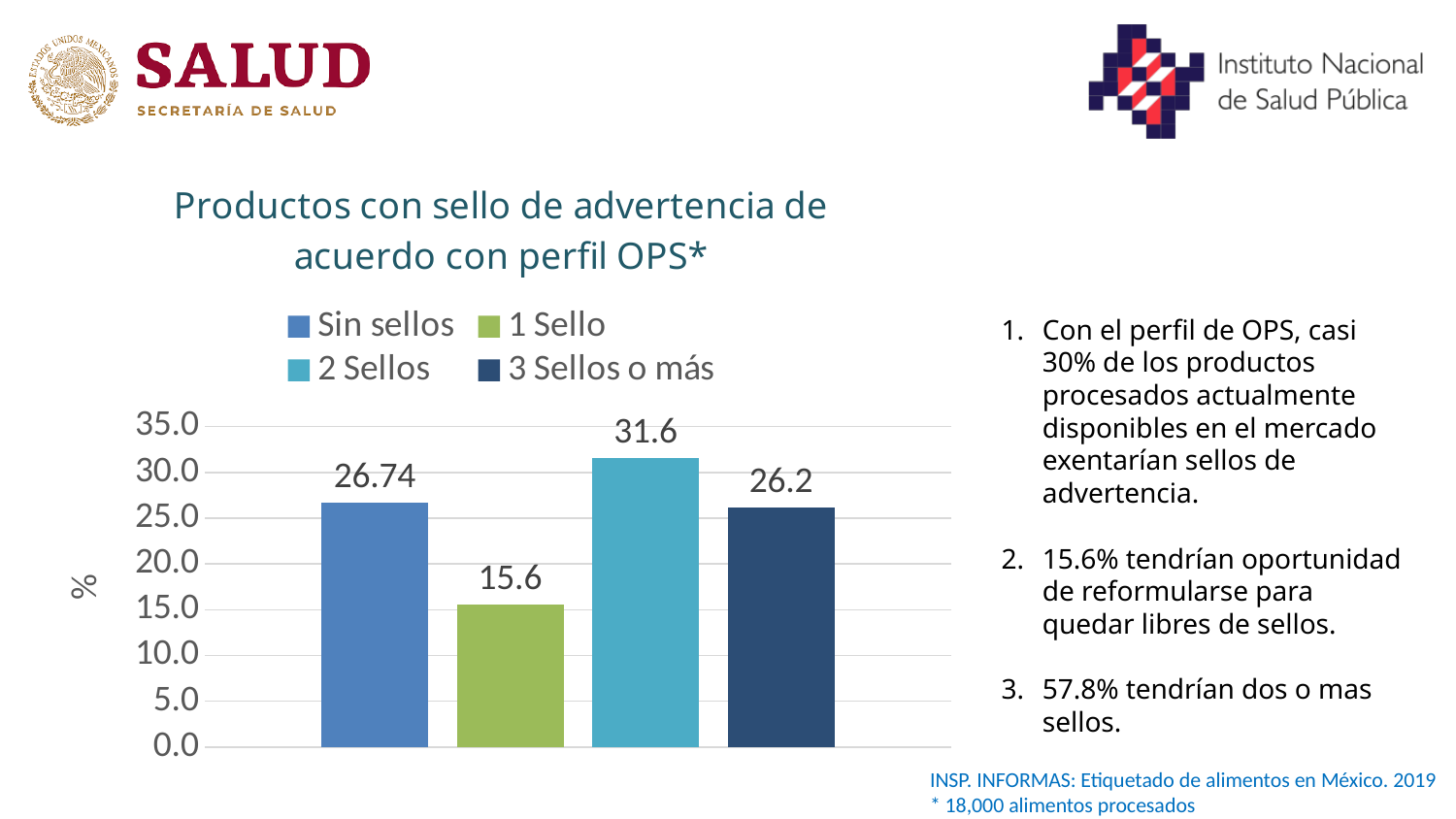
What is the value for "Sin sellos"? 26.74 Which is larger, the value for "Sin sellos" or the value for "3 Sellos o más"? Sin sellos What is the difference between the values for "2 Sellos" and "1 Sello"? 16.0 How many series does the legend list? 4 Which category has the highest value? 2 Sellos Which category has the lowest value? 1 Sello What is the title of the chart? Productos con sello de advertencia de acuerdo con perfil OPS* Is the value for "2 Sellos" greater or less than 30.0? greater What is the value for "3 Sellos o más"? 26.2 What is the value for "2 Sellos"? 31.6 What is the value for "1 Sello"? 15.6 What kind of chart is shown on the slide? Bar chart